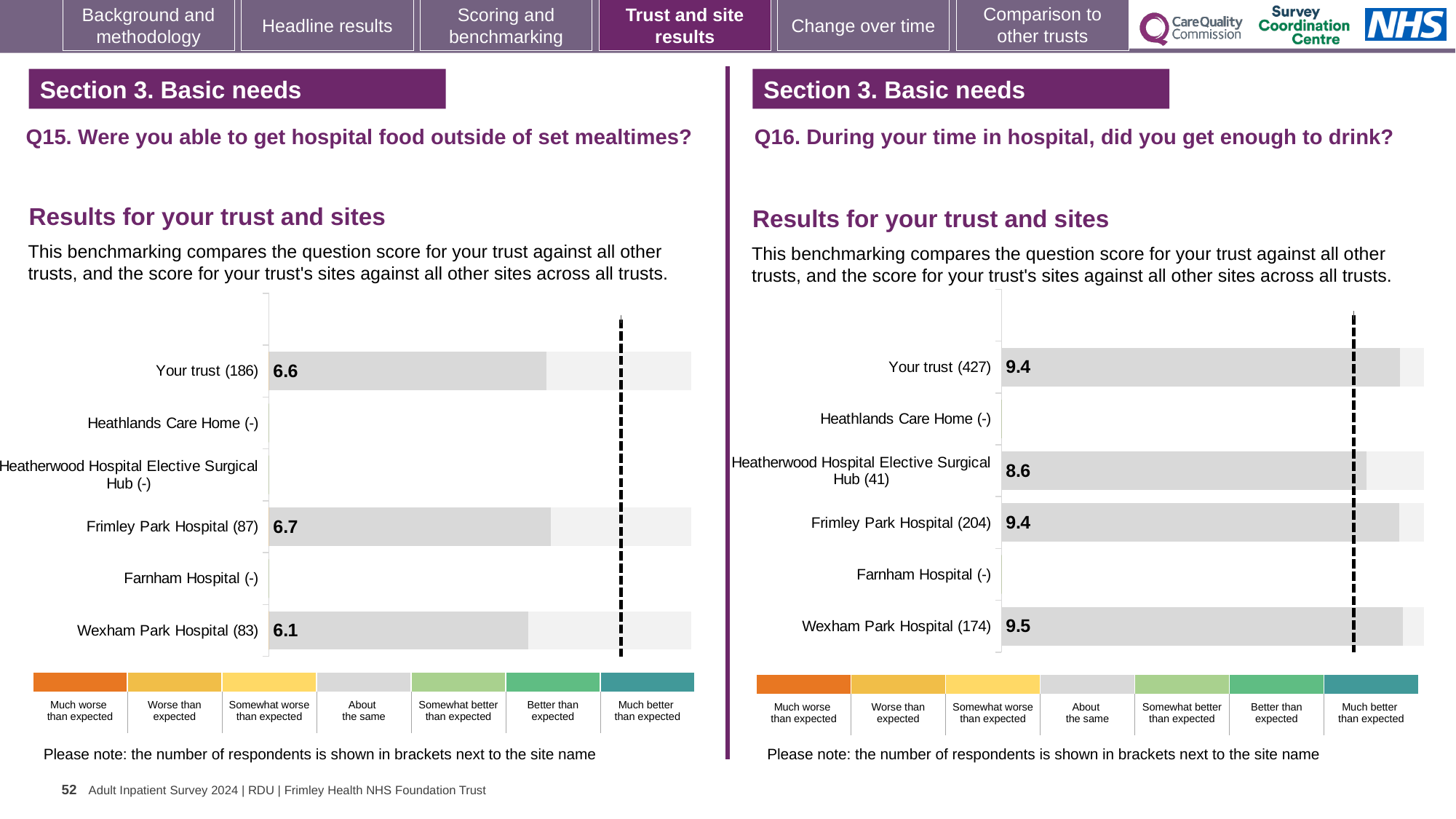
In the Q15 chart (left), what is the difference between the scores for Frimley Park Hospital and Wexham Park Hospital? 0.6 In the Q16 chart (right), what is the score for Heatherwood Hospital Elective Surgical Hub? 8.6 In the Q16 chart (right), what is the difference between the scores for Wexham Park Hospital and Heatherwood Hospital Elective Surgical Hub? 0.9 In the Q16 chart (right), what is the score for Wexham Park Hospital? 9.5 How many categories (rows) are listed on the Q15 chart (left)? 6 In the Q16 chart (right), which site has the lowest plotted score? Heatherwood Hospital Elective Surgical Hub In the Q15 chart (left), what is the score for Wexham Park Hospital? 6.1 In the Q15 chart (left), what is the score for Your trust? 6.6 In the Q15 chart (left), which site with a plotted score has the highest value? Frimley Park Hospital In the Q15 chart (left), how many respondents are shown for Your trust? 186 In the Q16 chart (right), is the score for Your trust larger or smaller than the score for Heatherwood Hospital Elective Surgical Hub? larger What type of chart is used for the Q16 results (right)? bar chart